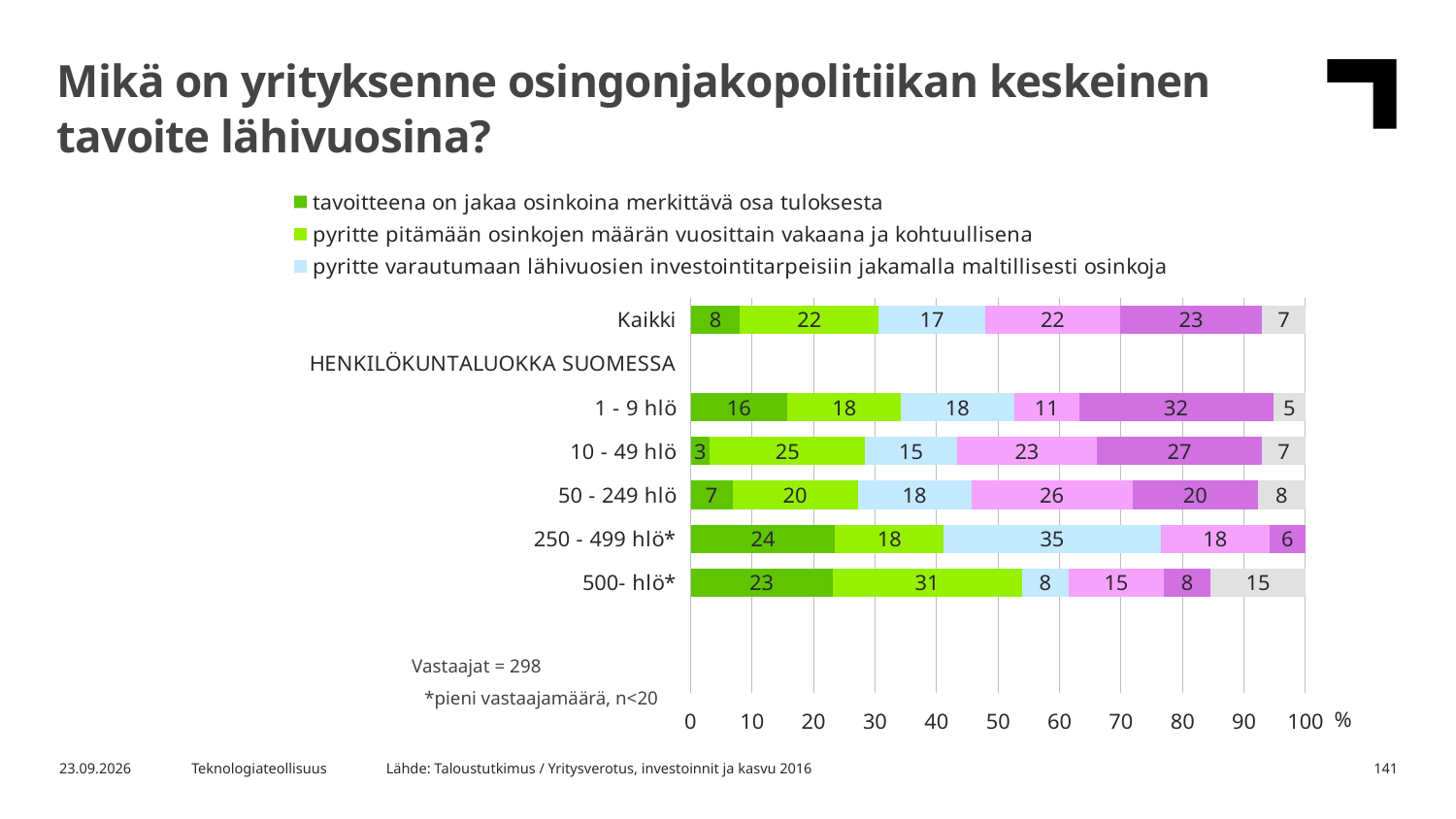
Which category has the lowest value for 'tavoitteena on jakaa osinkoina merkittävä osa tuloksesta'? 10 - 49 hlö What is the value of the 'tavoitteena on jakaa osinkoina merkittävä osa tuloksesta' segment for '1 - 9 hlö'? 16 Which category has the highest value for 'tavoitteena on jakaa osinkoina merkittävä osa tuloksesta'? 250 - 499 hlö* What type of chart is shown on the slide? bar chart What is the value of the 'pyritte varautumaan lähivuosien investointitarpeisiin jakamalla maltillisesti osinkoja' segment for '250 - 499 hlö*'? 35 How many series does the legend list? 3 How many respondents (Vastaajat) does the slide state? 298 How many categories (bars) are plotted in the chart? 6 For 'Kaikki', what is the difference between the 'pyritte pitämään osinkojen määrän vuosittain vakaana ja kohtuullisena' value and the 'tavoitteena on jakaa osinkoina merkittävä osa tuloksesta' value? 14 Which has the larger 'pyritte varautumaan lähivuosien investointitarpeisiin jakamalla maltillisesti osinkoja' value: '1 - 9 hlö' or '10 - 49 hlö'? 1 - 9 hlö What is the value of the 'pyritte pitämään osinkojen määrän vuosittain vakaana ja kohtuullisena' segment for '500- hlö*'? 31 What is the total of all labelled segments in the 'Kaikki' bar? 99